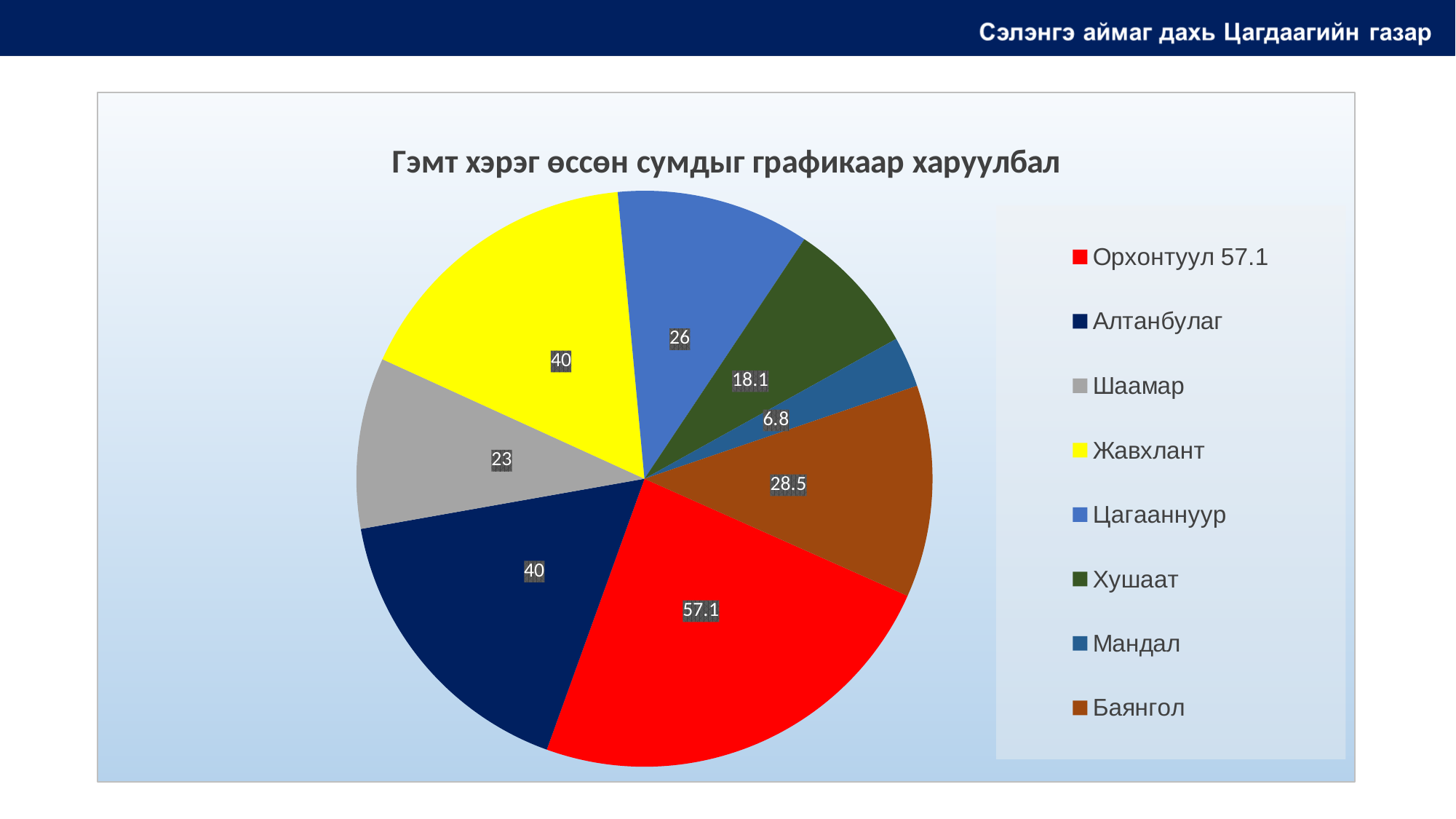
What is the value for Цагааннуур? 26 Which category has the largest slice of the pie? Орхонтуул Which category has the smallest slice of the pie? Мандал What type of chart is shown on the slide? pie chart Which is larger, the value for Баянгол or the value for Цагааннуур? Баянгол What is the value for Хушаат? 18.1 Which colour represents Жавхлант in the pie chart? yellow What is the value for Орхонтуул? 57.1 What is the value for Баянгол? 28.5 What is the title of the chart? Гэмт хэрэг өссөн сумдыг графикаар харуулбал What is the difference between the values for Орхонтуул and Шаамар? 34.1 How many categories does the legend list? 8